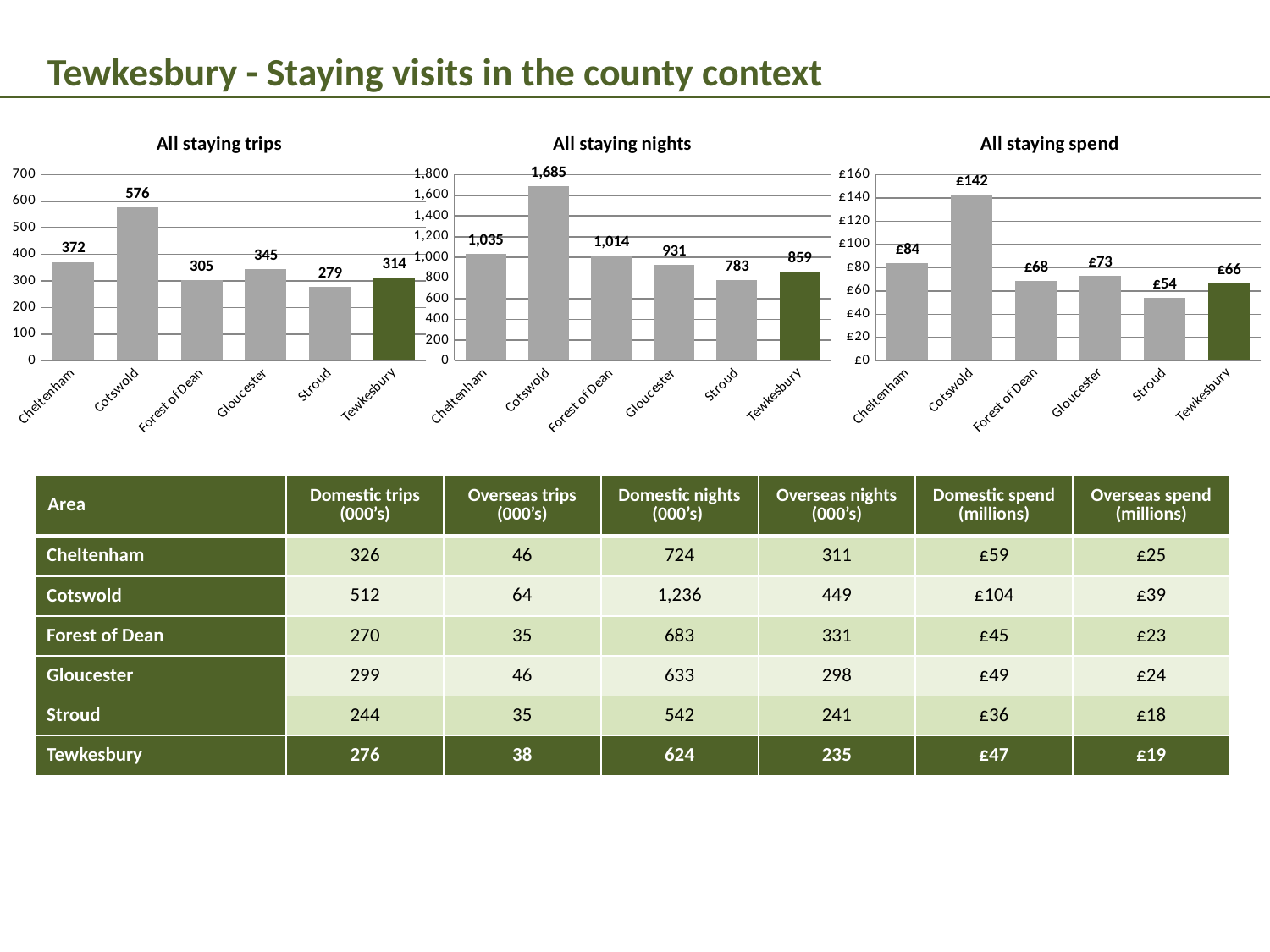
In the 'All staying trips' chart, which bar is coloured dark green rather than grey? Tewkesbury In the 'All staying spend' chart, which is larger, Forest of Dean or Tewkesbury? Forest of Dean In the 'All staying trips' chart, which area has the lowest value? Stroud In the 'All staying spend' chart, what is the difference between Cotswold and Stroud? £88 In the 'All staying trips' chart, which area has the highest value? Cotswold What type of chart is the 'All staying nights' chart? Bar chart In the 'All staying nights' chart, what is the value for Cotswold? 1,685 How many areas are shown in the 'All staying trips' chart? 6 In the 'All staying trips' chart, what is the value for Tewkesbury? 314 In the 'All staying nights' chart, which area has the lowest value? Stroud In the 'All staying nights' chart, what is the difference between Cheltenham and Tewkesbury? 176 In the 'All staying spend' chart, what is the value for Gloucester? £73